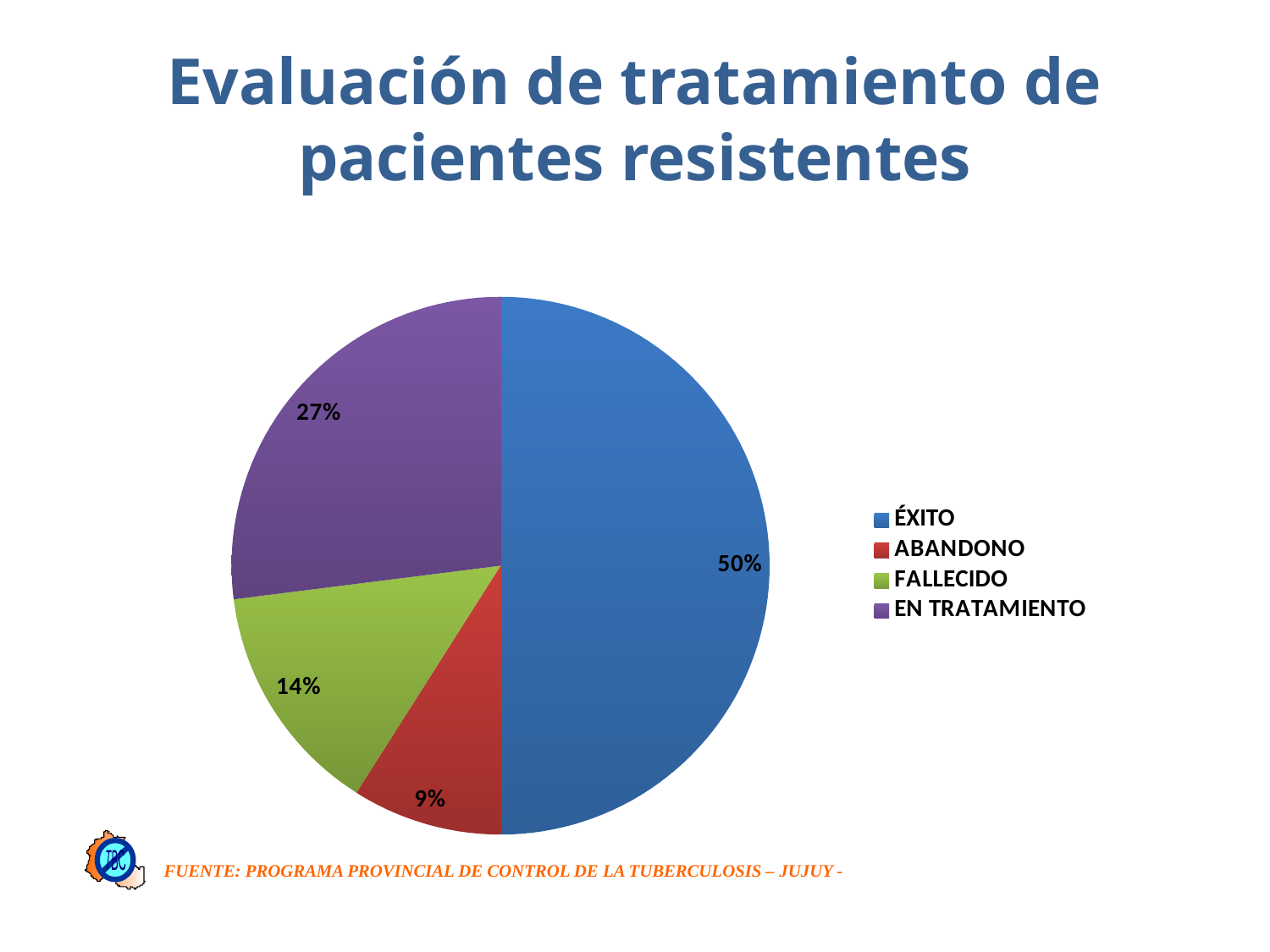
What is the value shown for EN TRATAMIENTO? 27% What share of the pie does ÉXITO represent? 50% What is the difference between the FALLECIDO and ABANDONO percentages? 5% Which category has the smallest slice of the pie? ABANDONO What colour is the slice for EN TRATAMIENTO? purple What kind of chart is shown on the slide? pie chart What is the value shown for ABANDONO? 9% What is the value shown for FALLECIDO? 14% Which is larger, the slice for FALLECIDO or the slice for EN TRATAMIENTO? EN TRATAMIENTO Which category has the largest slice of the pie? ÉXITO What is the difference between the ÉXITO and EN TRATAMIENTO percentages? 23% How many categories does the pie chart have? 4